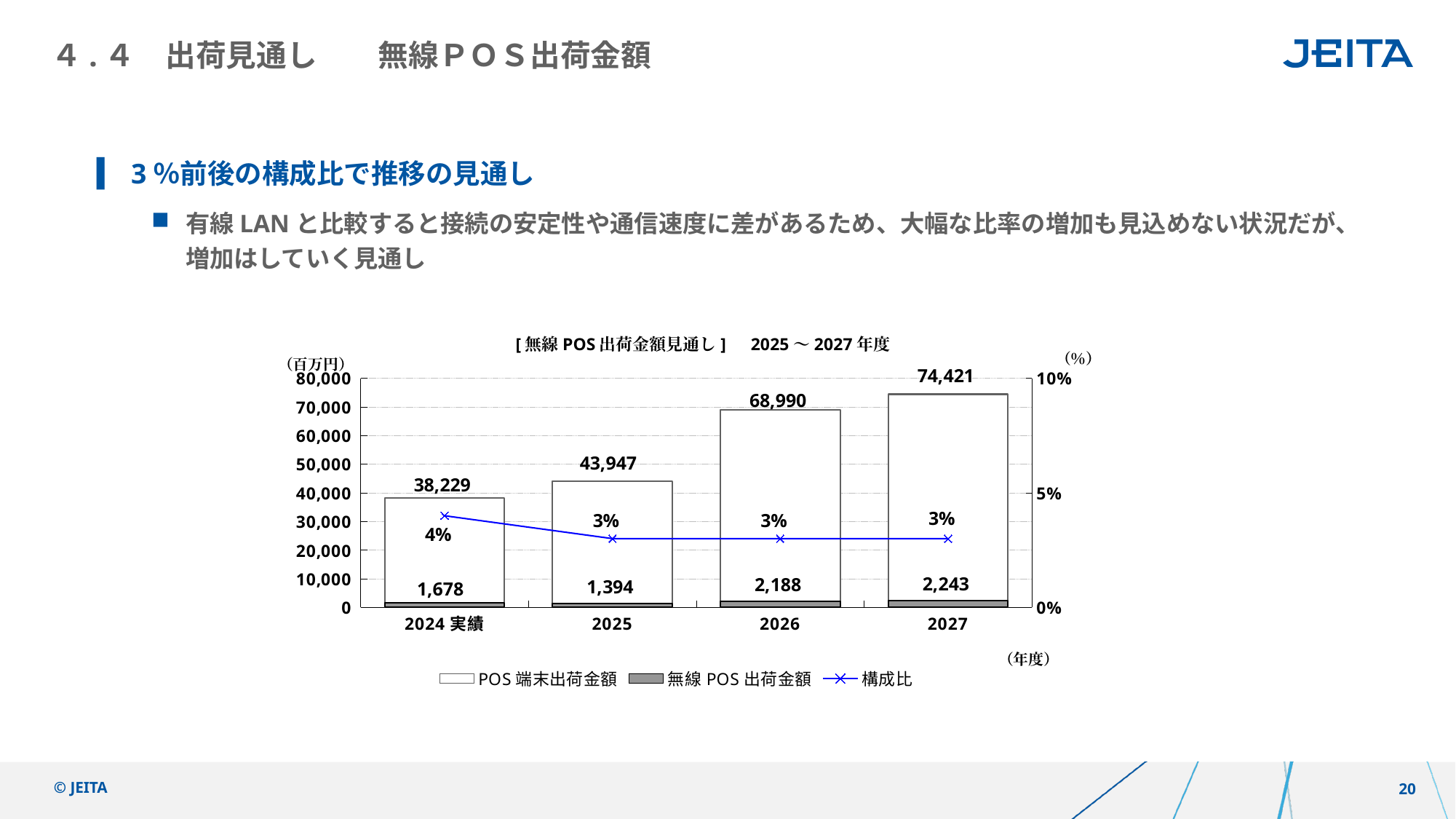
What is the 構成比 value for 2025? 3% What is the value of POS 端末出荷金額 for 2027? 74,421 Which year has the lowest 無線 POS 出荷金額 value? 2025 Does the POS 端末出荷金額 value rise or fall from 2024 実績 to 2027? rise What is the unit shown on the left vertical axis? 百万円 How many series does the legend list? 3 What is the difference between the POS 端末出荷金額 values for 2026 and 2025? 25,043 How many years are shown on the x axis? 4 Which is larger, the 無線 POS 出荷金額 value for 2024 実績 or for 2025? 2024 実績 What is the difference between the 無線 POS 出荷金額 values for 2027 and 2026? 55 Which year has the highest POS 端末出荷金額 value? 2027 What is the value of 無線 POS 出荷金額 for 2024 実績? 1,678